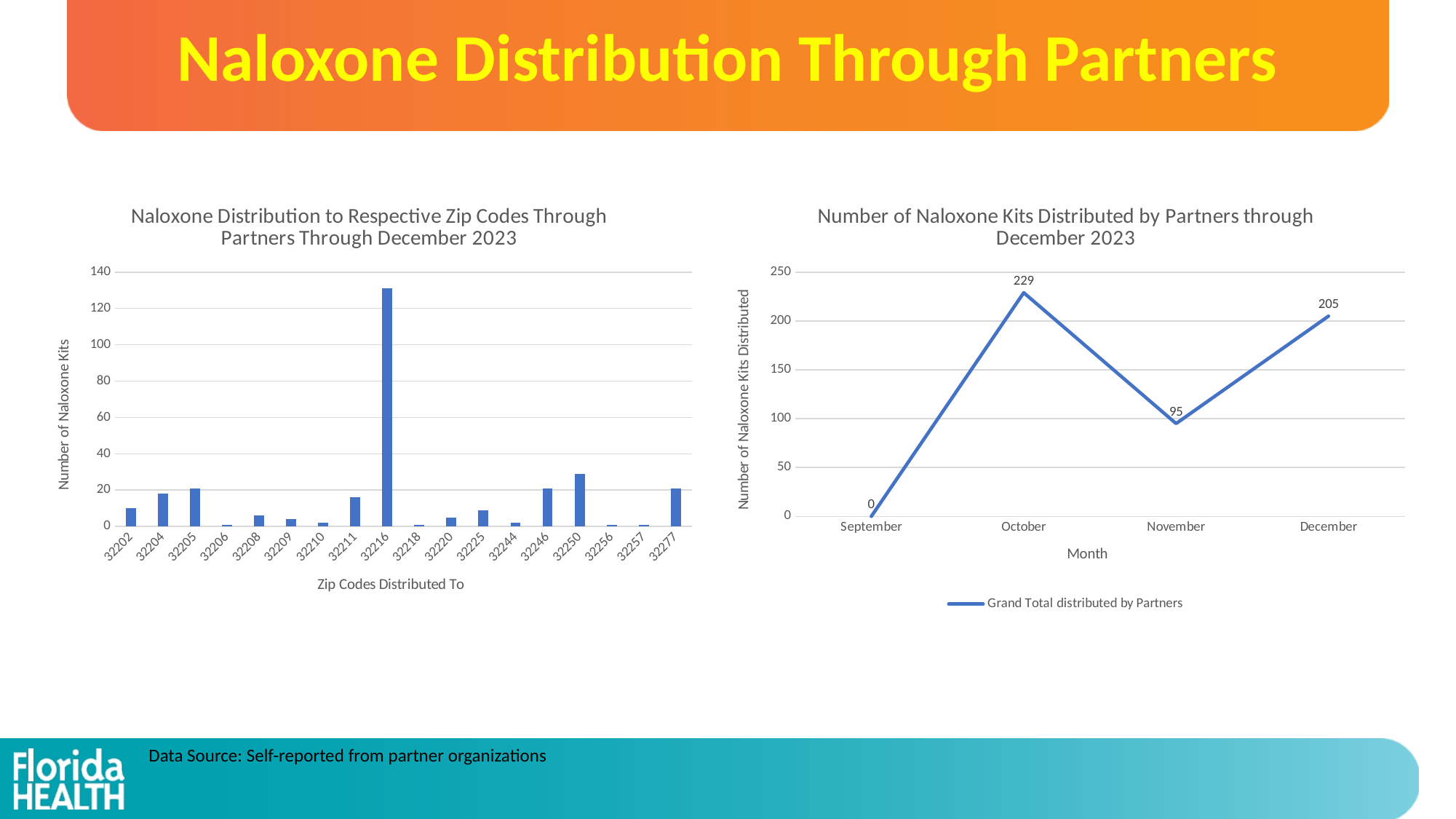
In the chart 'Naloxone Distribution to Respective Zip Codes Through Partners Through December 2023', how many zip codes are shown on the x axis? 18 In the chart 'Number of Naloxone Kits Distributed by Partners through December 2023', which month has the highest value? October What kind of chart is 'Naloxone Distribution to Respective Zip Codes Through Partners Through December 2023'? bar chart In the chart 'Naloxone Distribution to Respective Zip Codes Through Partners Through December 2023', is the value for zip code 32216 greater or less than 120? greater In the chart 'Number of Naloxone Kits Distributed by Partners through December 2023', what is the legend entry for the plotted series? Grand Total distributed by Partners In the chart 'Naloxone Distribution to Respective Zip Codes Through Partners Through December 2023', which is larger, the value for 32250 or the value for 32204? 32250 In the chart 'Naloxone Distribution to Respective Zip Codes Through Partners Through December 2023', is the value for zip code 32250 greater or less than 40? less In the chart 'Number of Naloxone Kits Distributed by Partners through December 2023', how many kits were distributed in October? 229 In the chart 'Number of Naloxone Kits Distributed by Partners through December 2023', how many kits were distributed in November? 95 In the chart 'Naloxone Distribution to Respective Zip Codes Through Partners Through December 2023', which zip code has the highest number of naloxone kits? 32216 In the chart 'Number of Naloxone Kits Distributed by Partners through December 2023', what is the difference between the October and December values? 24 In the chart 'Number of Naloxone Kits Distributed by Partners through December 2023', what kind of chart is shown? line chart